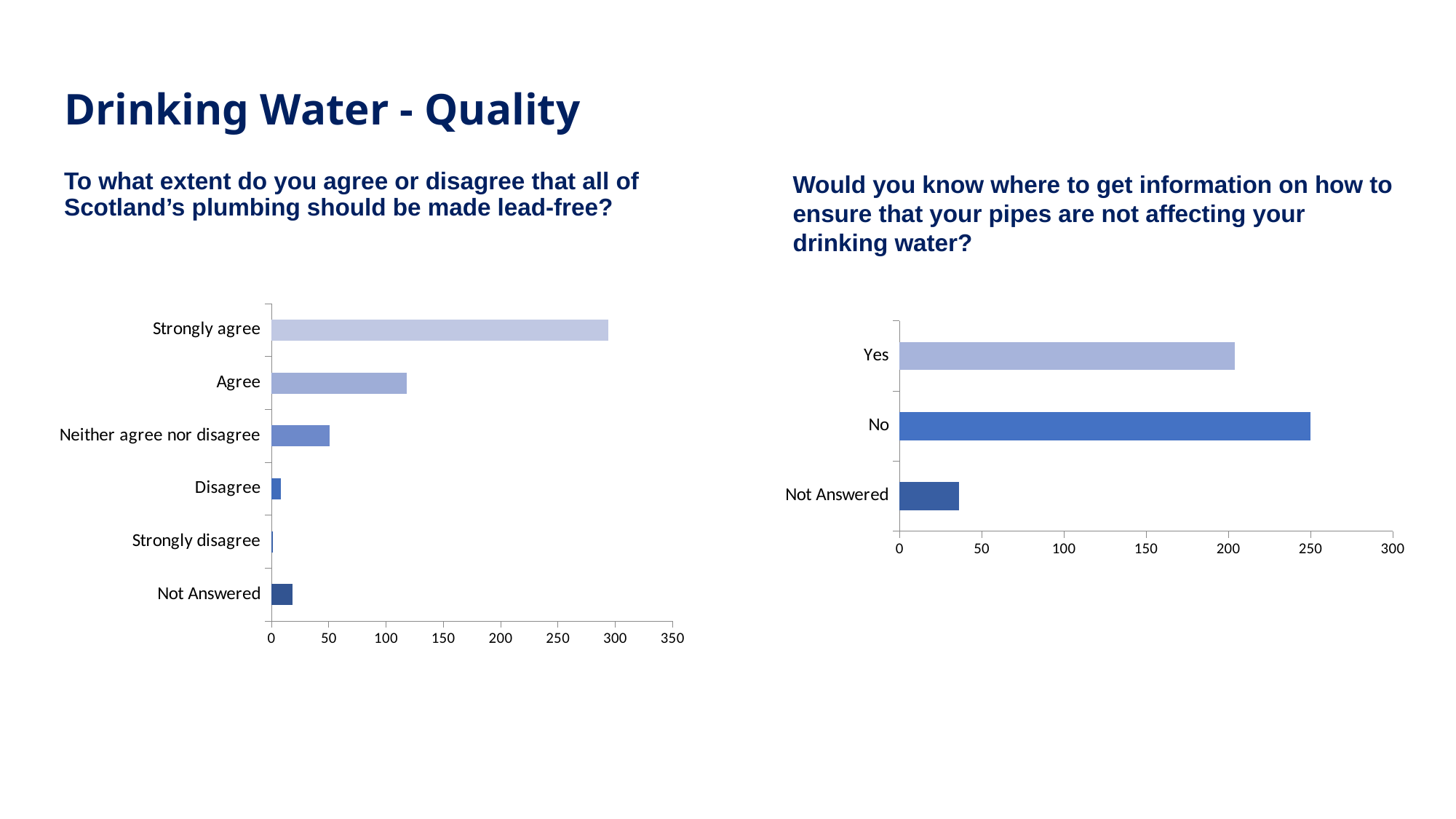
In the right chart about knowing where to get information, which category has the highest value? No How many categories are shown in the left chart about lead-free plumbing? 6 In the left chart about lead-free plumbing, is the value for Not Answered greater or less than 50? less In the left chart about lead-free plumbing, which category has the lowest value? Strongly disagree In the right chart about knowing where to get information, is the value for Yes greater or less than 150? greater In the left chart about lead-free plumbing, which category has the highest value? Strongly agree In the right chart about knowing where to get information, which category has the lowest value? Not Answered What kind of chart is the right chart about knowing where to get information? bar chart In the left chart about lead-free plumbing, is the value for Agree greater or less than 100? greater How many categories are shown in the right chart about knowing where to get information? 3 In the left chart about lead-free plumbing, which is larger, Agree or Neither agree nor disagree? Agree